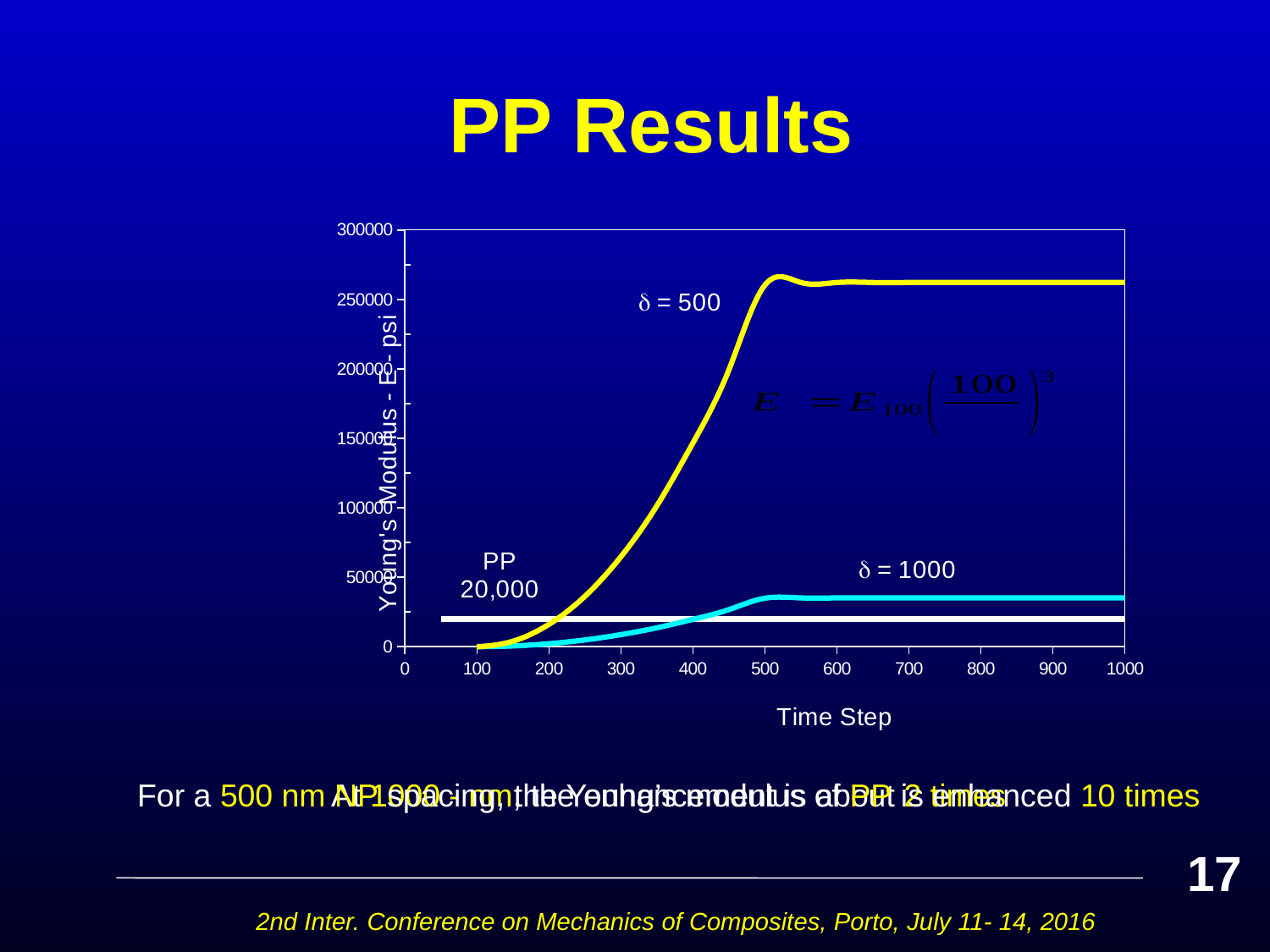
What value is labelled for PP on the chart? 20,000 How many δ curves are plotted on the chart? 2 At time step 1000, is the value for δ = 1000 greater or less than 50000? less What kind of chart is shown on the slide? line chart What is the title of the x axis of the chart? Time Step Which curve stays lowest over the time steps, δ = 500 or δ = 1000? δ = 1000 At time step 1000, which is larger, the value for δ = 500 or the value for δ = 1000? δ = 500 At time step 1000, is the value for δ = 500 greater or less than 250000? greater At time step 400, is the value for δ = 500 greater or less than 100000? greater What is the title of the y axis of the chart? Young's Modulus - E - psi Which curve reaches the highest Young's modulus, δ = 500 or δ = 1000? δ = 500 Does the δ = 500 curve rise or fall between time step 100 and time step 500? rise